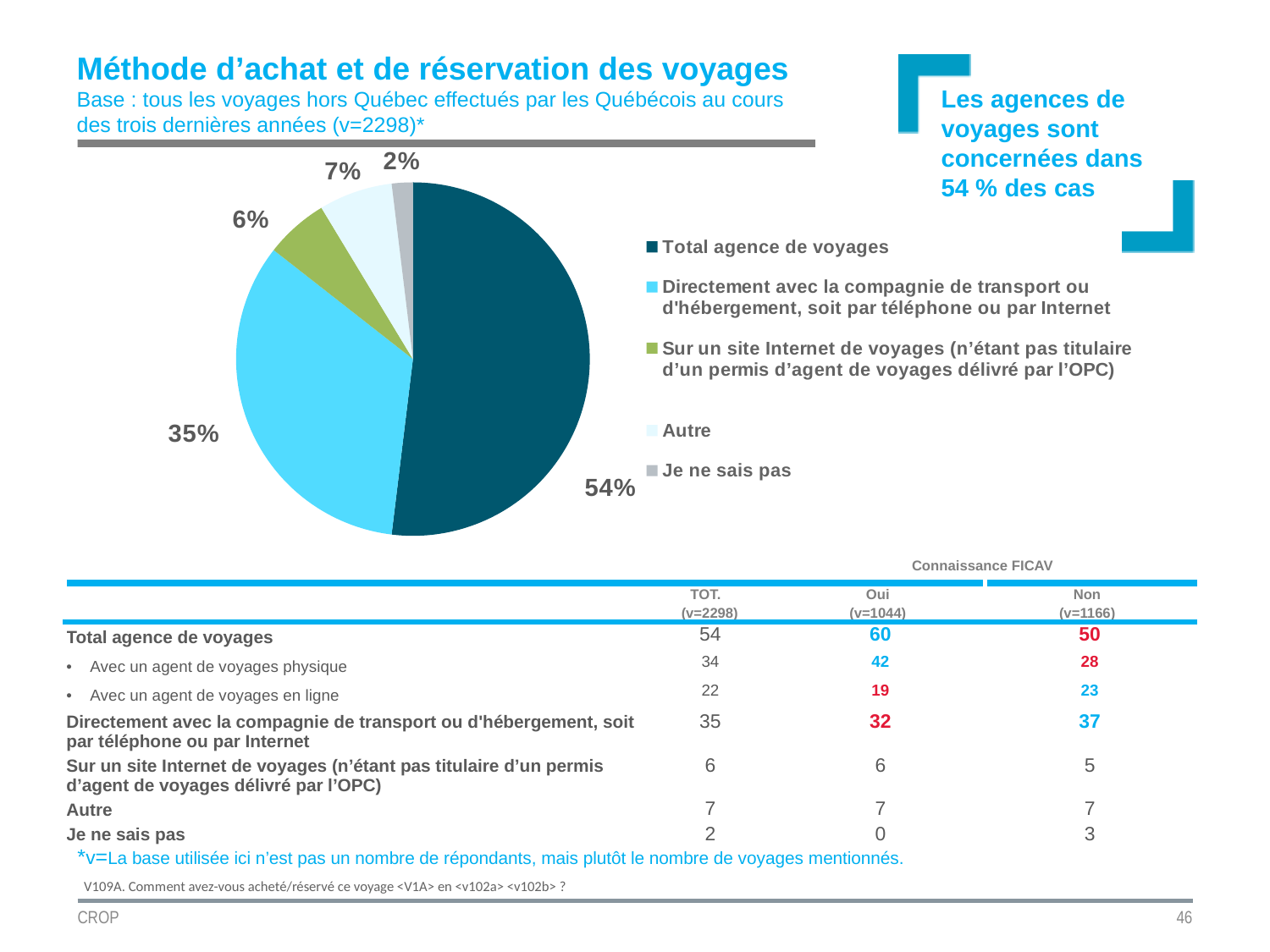
Which category has the smallest slice of the pie? Je ne sais pas What is the title of the slide containing the pie chart? Méthode d’achat et de réservation des voyages What is the value for "Autre" in the pie chart? 7% What is the value for "Directement avec la compagnie de transport ou d'hébergement, soit par téléphone ou par Internet" in the pie chart? 35% How many entries does the legend list? 5 Which is larger: the slice for "Autre" or the slice for "Sur un site Internet de voyages"? Autre What is the difference in percentage points between "Total agence de voyages" and "Directement avec la compagnie de transport ou d'hébergement"? 19 What share of the pie does "Total agence de voyages" represent? 54% Which category has the largest slice of the pie? Total agence de voyages What is the value for "Je ne sais pas" in the pie chart? 2% What kind of chart is shown on the slide? pie chart How many slices does the pie chart have? 5